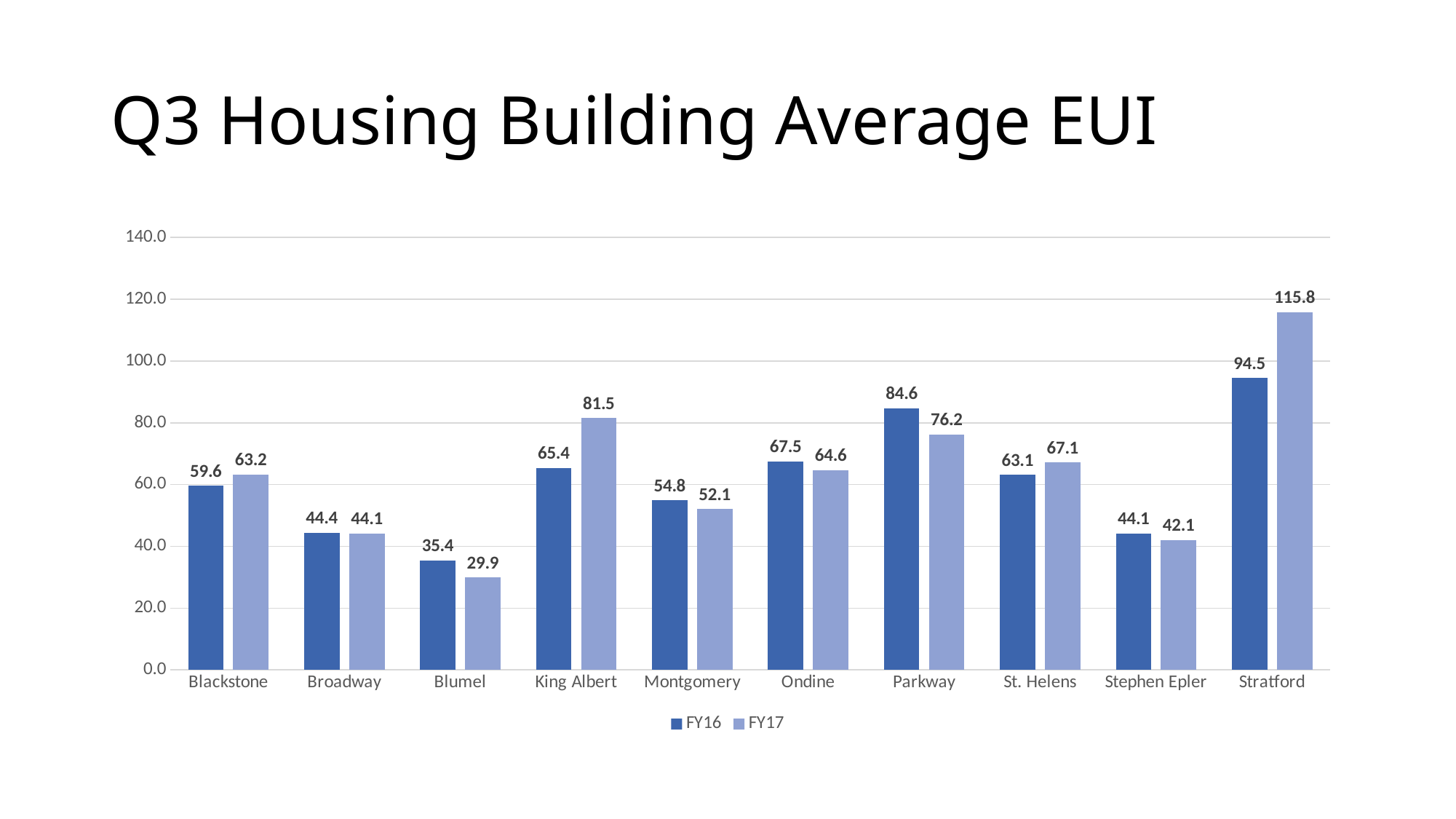
Which building has the lowest FY16 value? Blumel How many buildings are shown on the x axis? 10 What kind of chart is shown on the slide? Bar chart Is the FY17 value for King Albert greater or less than 80.0? greater How many series does the legend list? 2 Which building has the highest FY17 value? Stratford What is the FY17 value for Blumel? 29.9 What is the difference between the FY17 and FY16 values for Stratford? 21.3 Which is larger for Montgomery, the FY16 value or the FY17 value? FY16 What is the FY16 value for King Albert? 65.4 What is the FY17 value for Stratford? 115.8 What is the difference between the FY16 and FY17 values for Parkway? 8.4